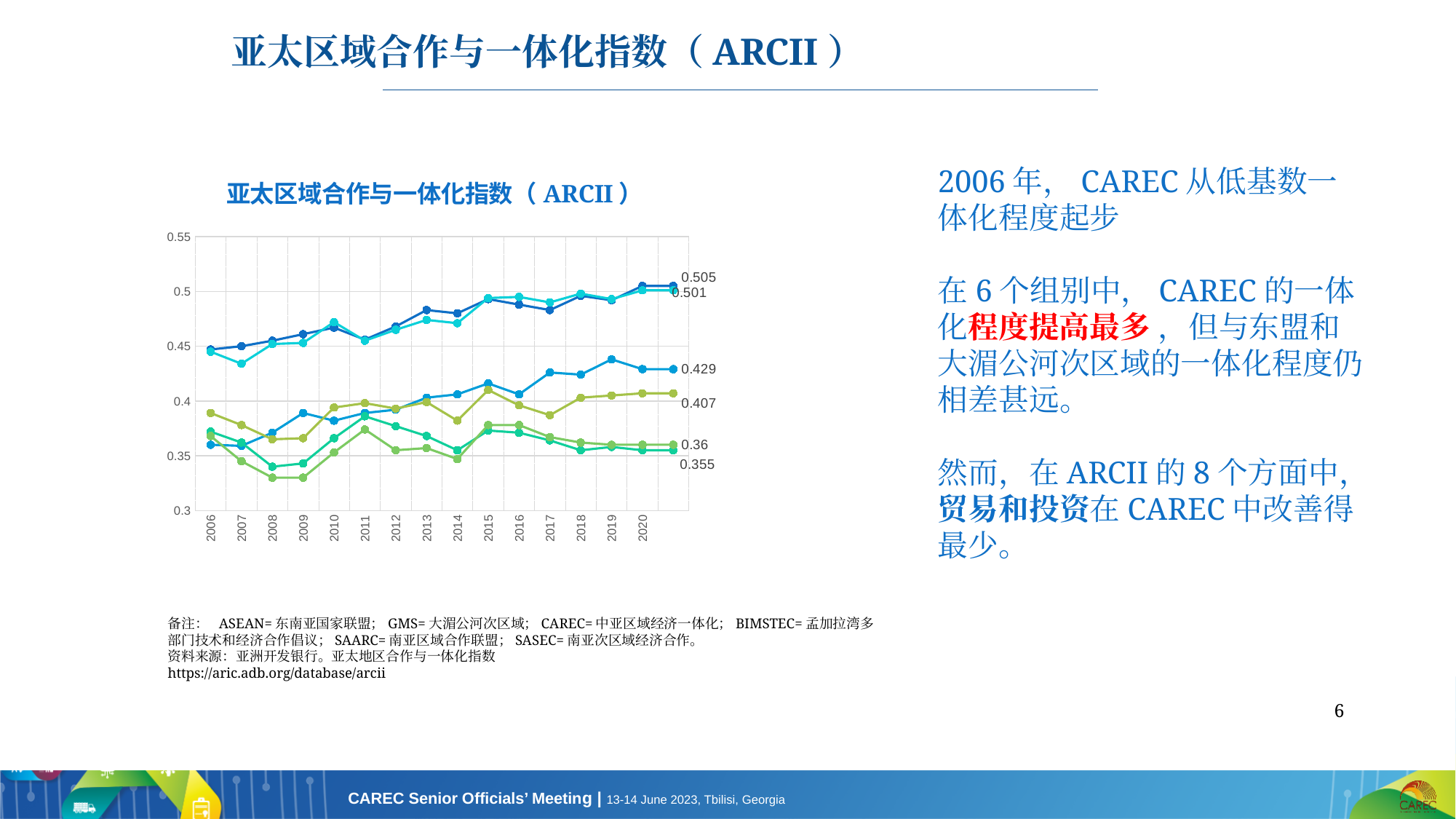
What is the title of the chart? 亚太区域合作与一体化指数（ARCII） Which end-point label is larger, 0.429 or 0.407? 0.429 Is the highest value plotted in 2015 greater or less than 0.45? greater How many year labels are shown on the x axis of the chart? 15 What is the highest end-point value labelled on the chart? 0.505 What is the first year shown on the x axis of the chart? 2006 Is the lowest value plotted in 2008 greater or less than 0.35? less How many lines are plotted in the chart? 6 What is the difference between the highest and lowest end-point labels on the chart (0.505 and 0.355)? 0.15 What is the lowest end-point value labelled on the chart? 0.355 What kind of chart is shown on the slide? line chart Does the top line in the chart generally rise or fall from 2006 to the end of the series? rise